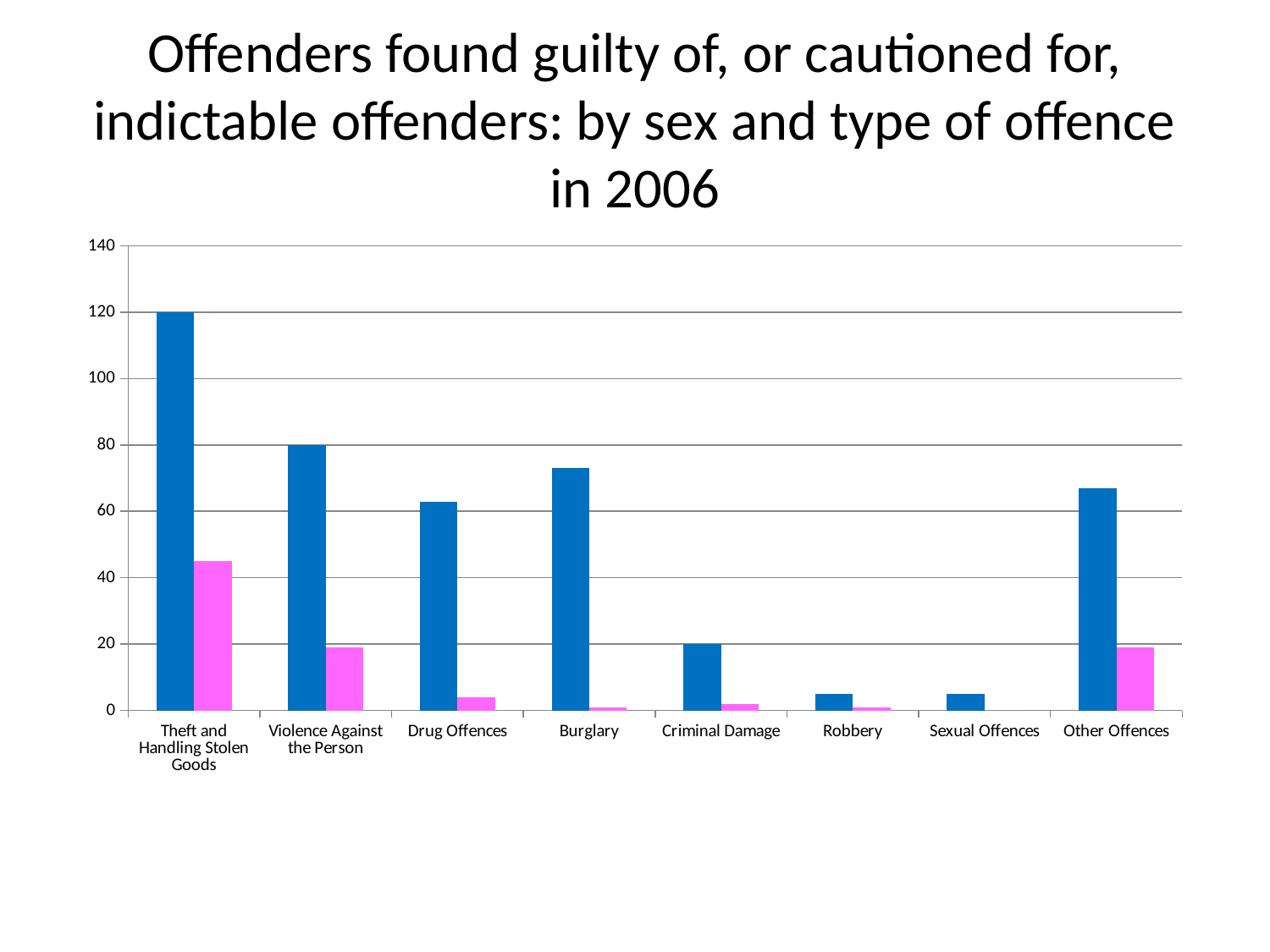
What is the difference between the blue bars for Theft and Handling Stolen Goods and Violence Against the Person? 40 What kind of chart is shown on the slide? bar chart Which offence category has the highest blue bar? Theft and Handling Stolen Goods How many offence categories are shown on the x axis? 8 What is the value of the blue bar for Theft and Handling Stolen Goods? 120 What is the value of the blue bar for Violence Against the Person? 80 What is the value of the blue bar for Criminal Damage? 20 Is the blue bar for Burglary greater or less than 60? greater Which is larger, the blue bar for Violence Against the Person or the blue bar for Burglary? Violence Against the Person Which offence category has the highest pink bar? Theft and Handling Stolen Goods What year does the chart title say the data is for? 2006 Is the pink bar for Theft and Handling Stolen Goods greater or less than 40? greater